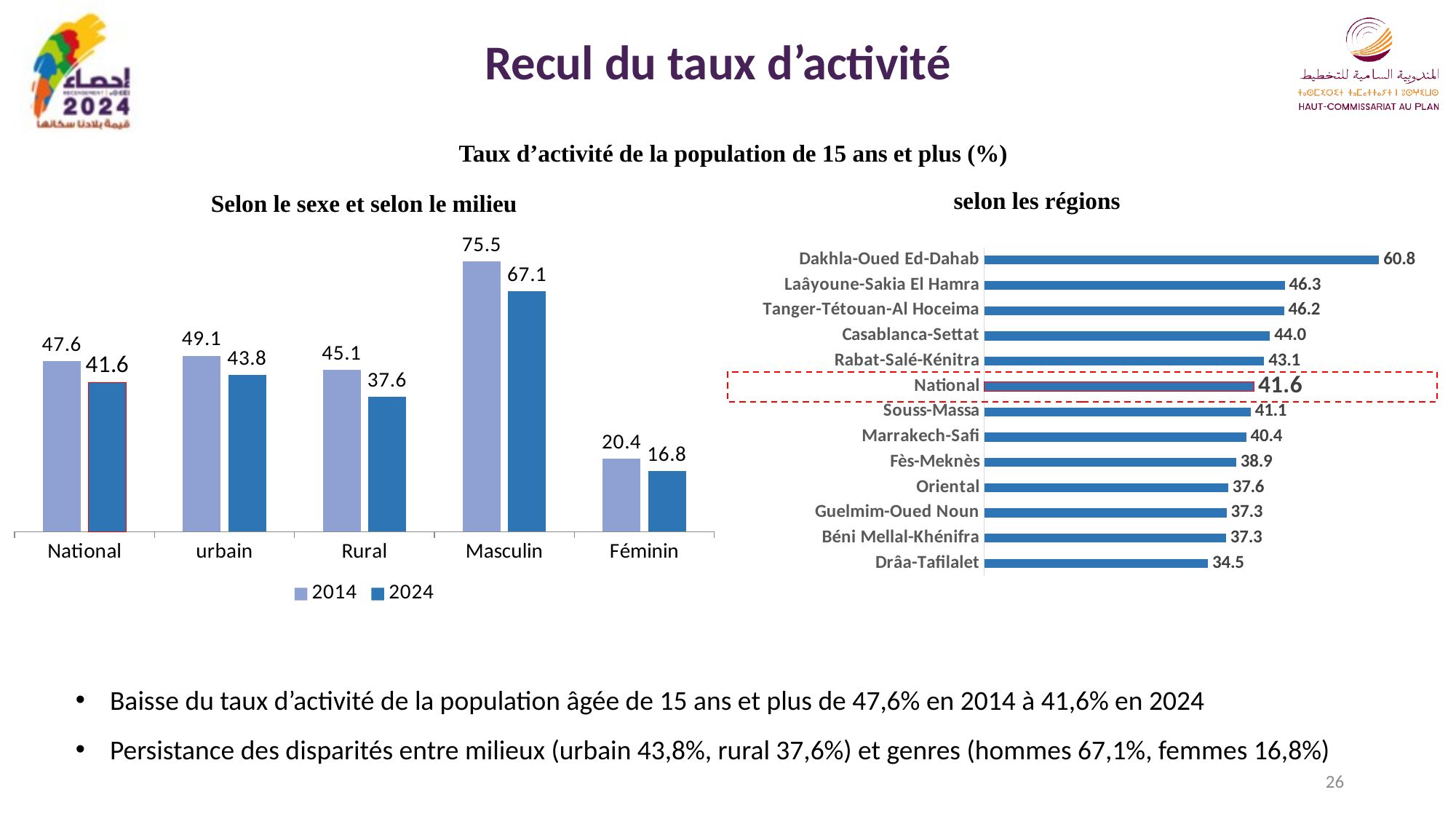
In the 'selon les régions' chart, which region has the highest value? Dakhla-Oued Ed-Dahab In the 'selon les régions' chart, what is the difference between Dakhla-Oued Ed-Dahab and Drâa-Tafilalet? 26.3 In the 'Selon le sexe et selon le milieu' chart, how many series does the legend list? 2 In the 'Selon le sexe et selon le milieu' chart, which category has the lowest 2024 value? Féminin In the 'Selon le sexe et selon le milieu' chart, what is the value for Masculin in 2024? 67.1 In the 'Selon le sexe et selon le milieu' chart, what is the difference between the National values for 2014 and 2024? 6.0 In the 'selon les régions' chart, which region has the lowest value? Drâa-Tafilalet In the 'selon les régions' chart, what is the value for Casablanca-Settat? 44.0 In the 'Selon le sexe et selon le milieu' chart, what is the value for Rural in 2014? 45.1 In the 'selon les régions' chart, which is larger: Souss-Massa or Fès-Meknès? Souss-Massa What type of chart is the 'selon les régions' chart? bar chart In the 'Selon le sexe et selon le milieu' chart, do the values for urbain rise or fall from 2014 to 2024? fall